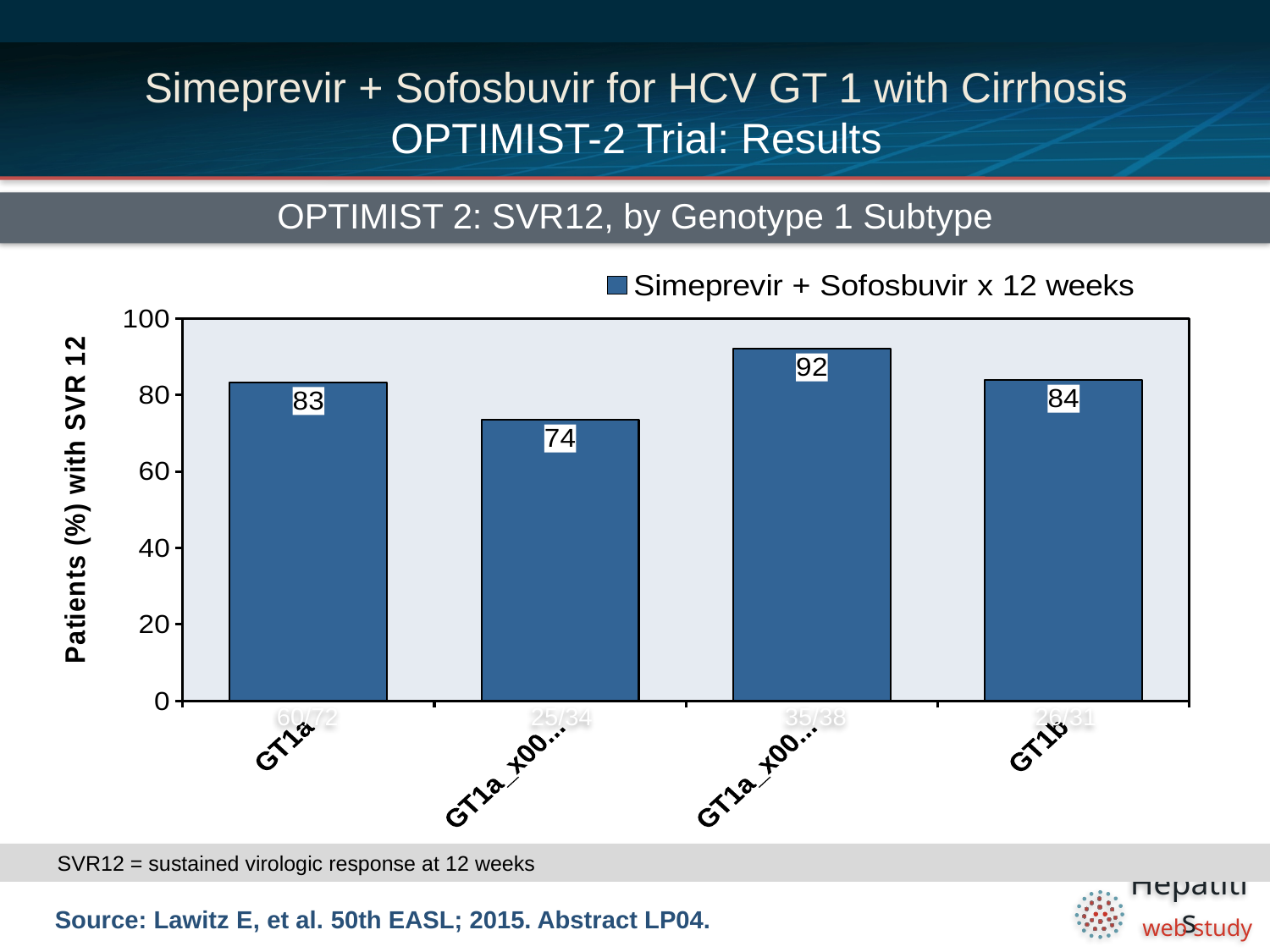
Which bar has the highest value? The third bar from the left (92) What type of chart is shown? Bar chart Which is larger, the value for GT1a or the value for the second bar from the left? GT1a What value is printed on the third bar from the left? 92 Is the value for GT1b greater or less than 60? greater What is the legend entry for the series shown? Simeprevir + Sofosbuvir x 12 weeks What is the difference between the highest value (92) and the lowest value (74)? 18 What value is printed on the second bar from the left? 74 What is the SVR12 value for GT1a? 83 Which bar has the lowest value? The second bar from the left (74) How many bars are shown in the chart? 4 What is the SVR12 value for GT1b? 84